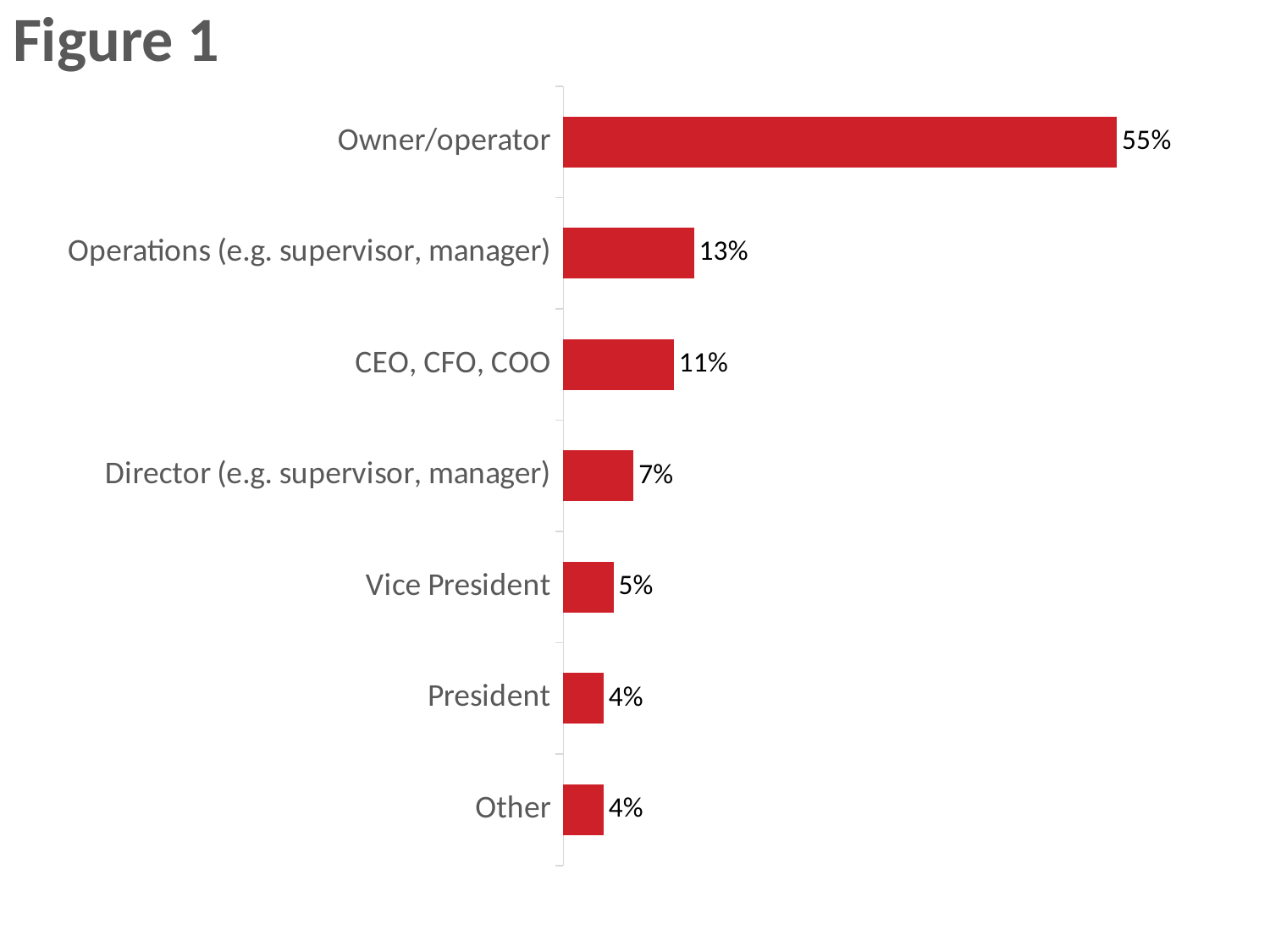
What is the value for Vice President? 5% How many categories are shown in the chart? 7 Which is larger, the value for Director (e.g. supervisor, manager) or the value for Vice President? Director (e.g. supervisor, manager) What is the difference between the values for Owner/operator and Operations (e.g. supervisor, manager)? 42% What is the title shown above the chart? Figure 1 What is the difference between the values for CEO, CFO, COO and Director (e.g. supervisor, manager)? 4% Which is larger, the value for Operations (e.g. supervisor, manager) or the value for CEO, CFO, COO? Operations (e.g. supervisor, manager) What is the value for Operations (e.g. supervisor, manager)? 13% What is the value for Owner/operator? 55% What is the value for CEO, CFO, COO? 11% Which category has the highest value? Owner/operator What kind of chart is shown on the slide? Bar chart